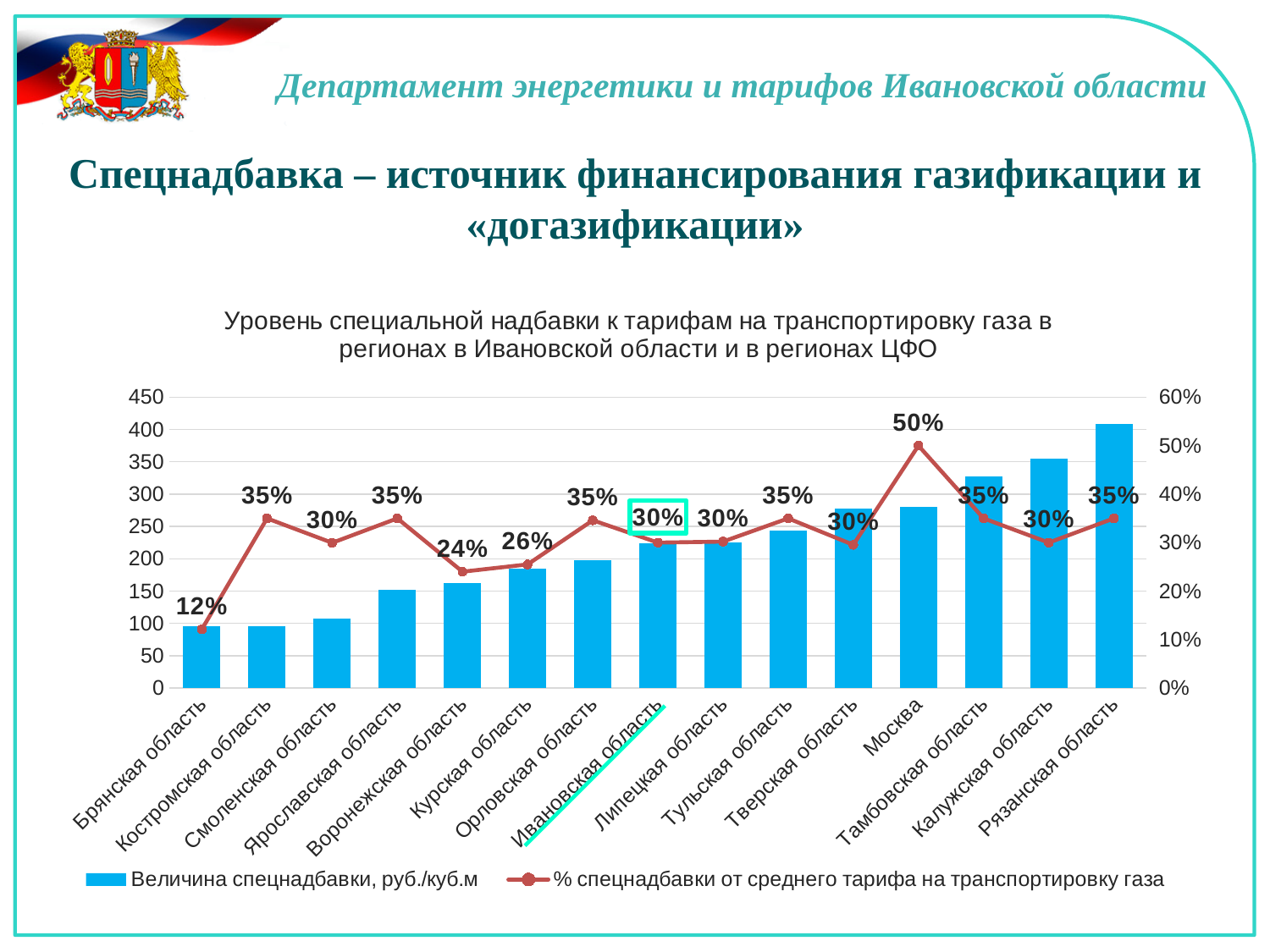
Which region has the lowest % спецнадбавки от среднего тарифа на транспортировку газа? Брянская область What is the % спецнадбавки от среднего тарифа value for Брянская область? 12% Which has a higher % спецнадбавки от среднего тарифа: Воронежская область or Курская область? Курская область How many series does the chart legend list? 2 Which region has the tallest bar for Величина спецнадбавки, руб./куб.м? Рязанская область What is the difference in percentage points between the % спецнадбавки for Москва and for Брянская область? 38 percentage points Which region has the highest % спецнадбавки от среднего тарифа на транспортировку газа? Москва Is the Величина спецнадбавки bar for Калужская область greater or less than 300? greater What is the % спецнадбавки от среднего тарифа value for Москва? 50% How many regions are shown on the x axis of the chart? 15 What is the % спецнадбавки от среднего тарифа value for Ивановская область? 30% Is the Величина спецнадбавки bar for Москва greater or less than 300? less